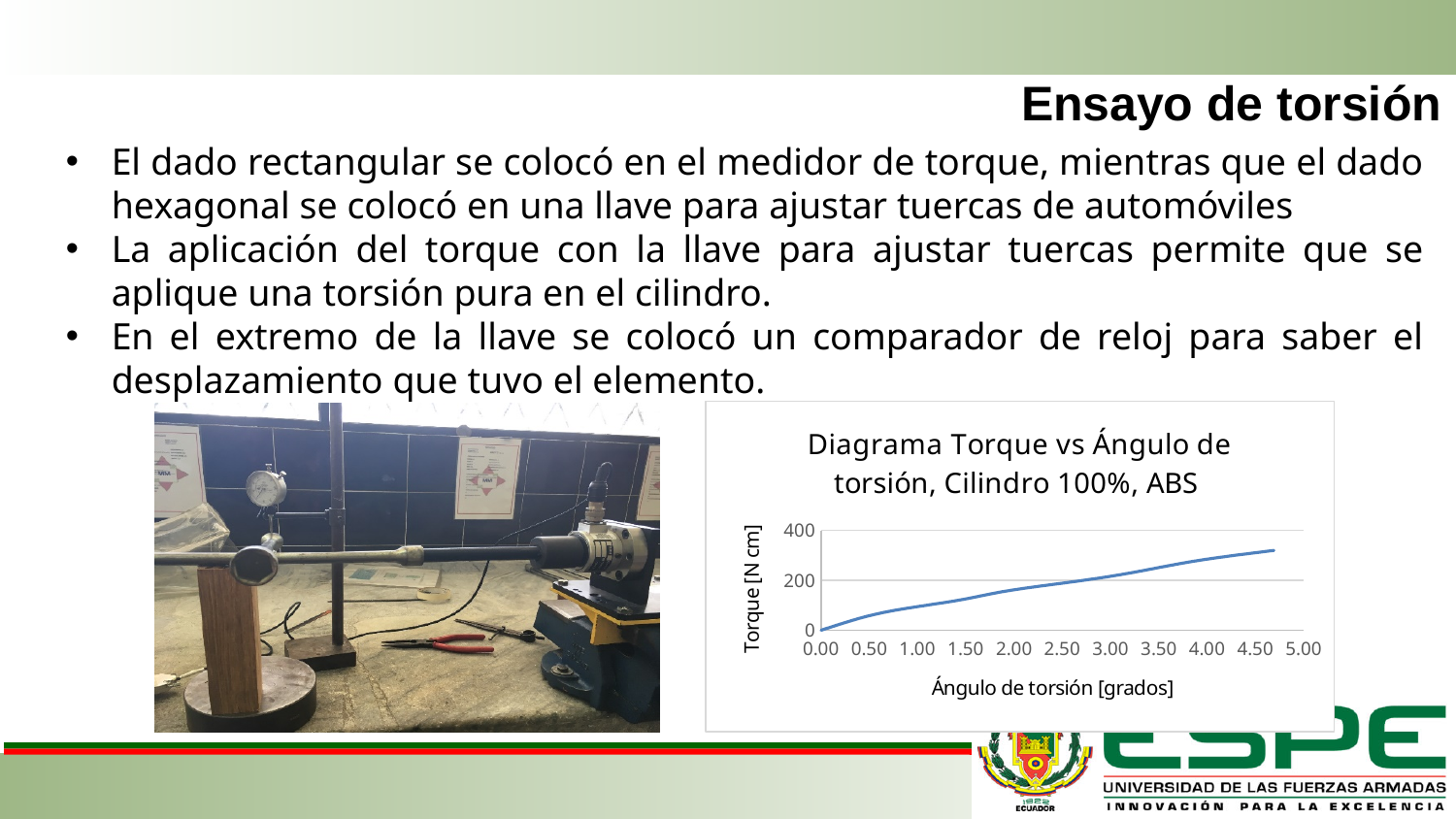
Is the torque value at an angle of 4.00 degrees greater or less than 400? less Does the torque rise or fall as the angle of torsion increases along the x axis? rise Is the torque value at an angle of 4.50 degrees greater or less than 200? greater What kind of chart is shown on the slide? line chart Is the torque at 4.00 degrees larger or smaller than the torque at 2.00 degrees? larger Is the torque value at an angle of 3.50 degrees greater or less than 200? greater What is the highest value shown on the vertical axis of the chart? 400 What is the title of the chart on the slide? Diagrama Torque vs Ángulo de torsión, Cilindro 100%, ABS What is the label of the vertical axis of the chart? Torque [N cm]